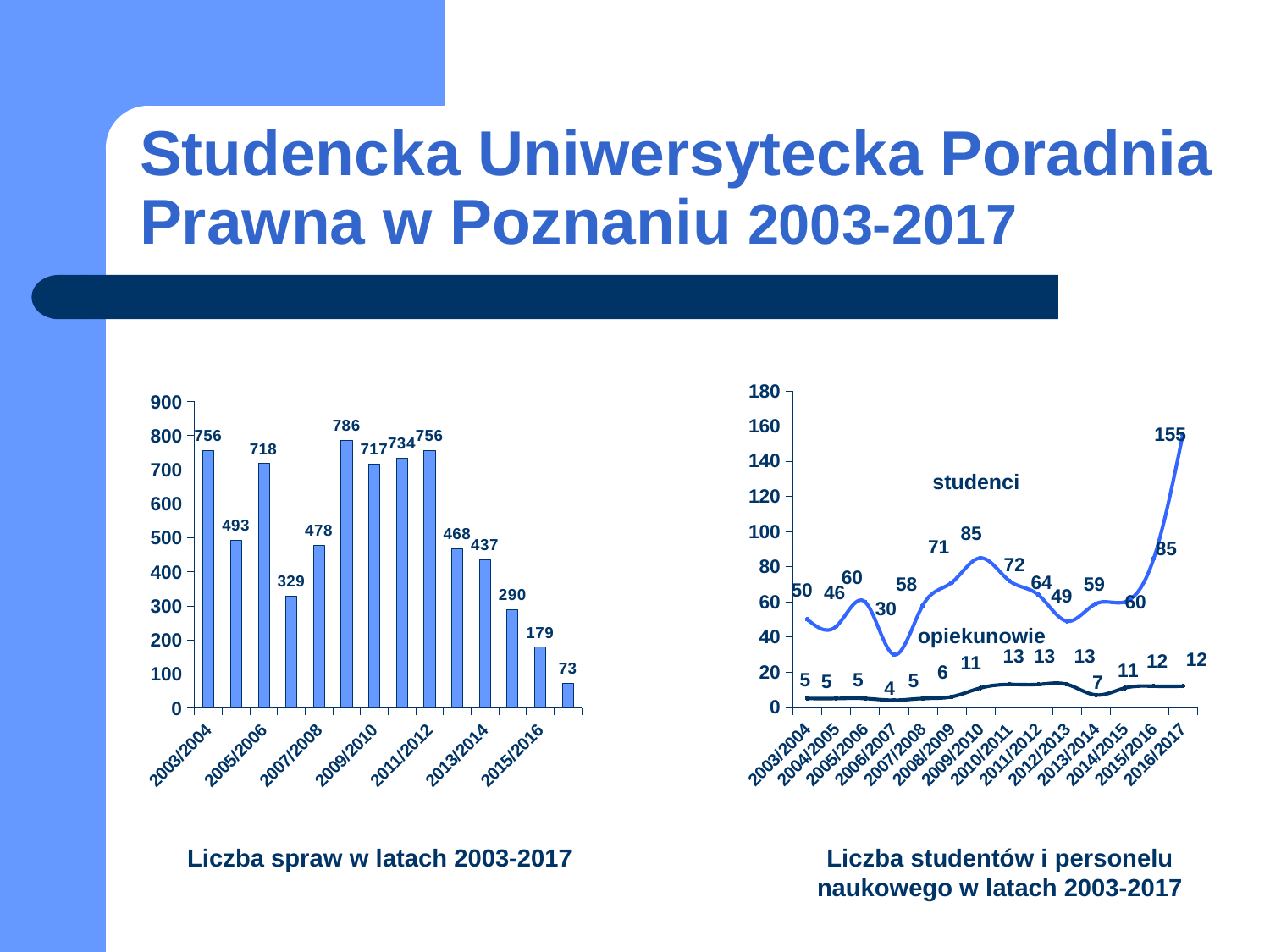
In the right chart 'Liczba studentów i personelu naukowego w latach 2003-2017', which year has the larger opiekunowie value, 2013/2014 or 2014/2015? 2014/2015 How many bars are in the left chart 'Liczba spraw w latach 2003-2017'? 14 In the left chart 'Liczba spraw w latach 2003-2017', what is the lowest value shown? 73 In the right chart 'Liczba studentów i personelu naukowego w latach 2003-2017', what is the value for studenci in 2016/2017? 155 In the left chart 'Liczba spraw w latach 2003-2017', what is the value for 2003/2004? 756 In the left chart 'Liczba spraw w latach 2003-2017', what is the value for 2015/2016? 179 What kind of chart is the left chart, 'Liczba spraw w latach 2003-2017'? bar chart In the right chart 'Liczba studentów i personelu naukowego w latach 2003-2017', in which year is the studenci value lowest? 2006/2007 In the left chart 'Liczba spraw w latach 2003-2017', what is the highest value shown? 786 How many series are plotted in the right chart 'Liczba studentów i personelu naukowego w latach 2003-2017'? 2 In the left chart 'Liczba spraw w latach 2003-2017', what is the difference between the values for 2003/2004 and 2013/2014? 319 What kind of chart is the right chart, 'Liczba studentów i personelu naukowego w latach 2003-2017'? line chart